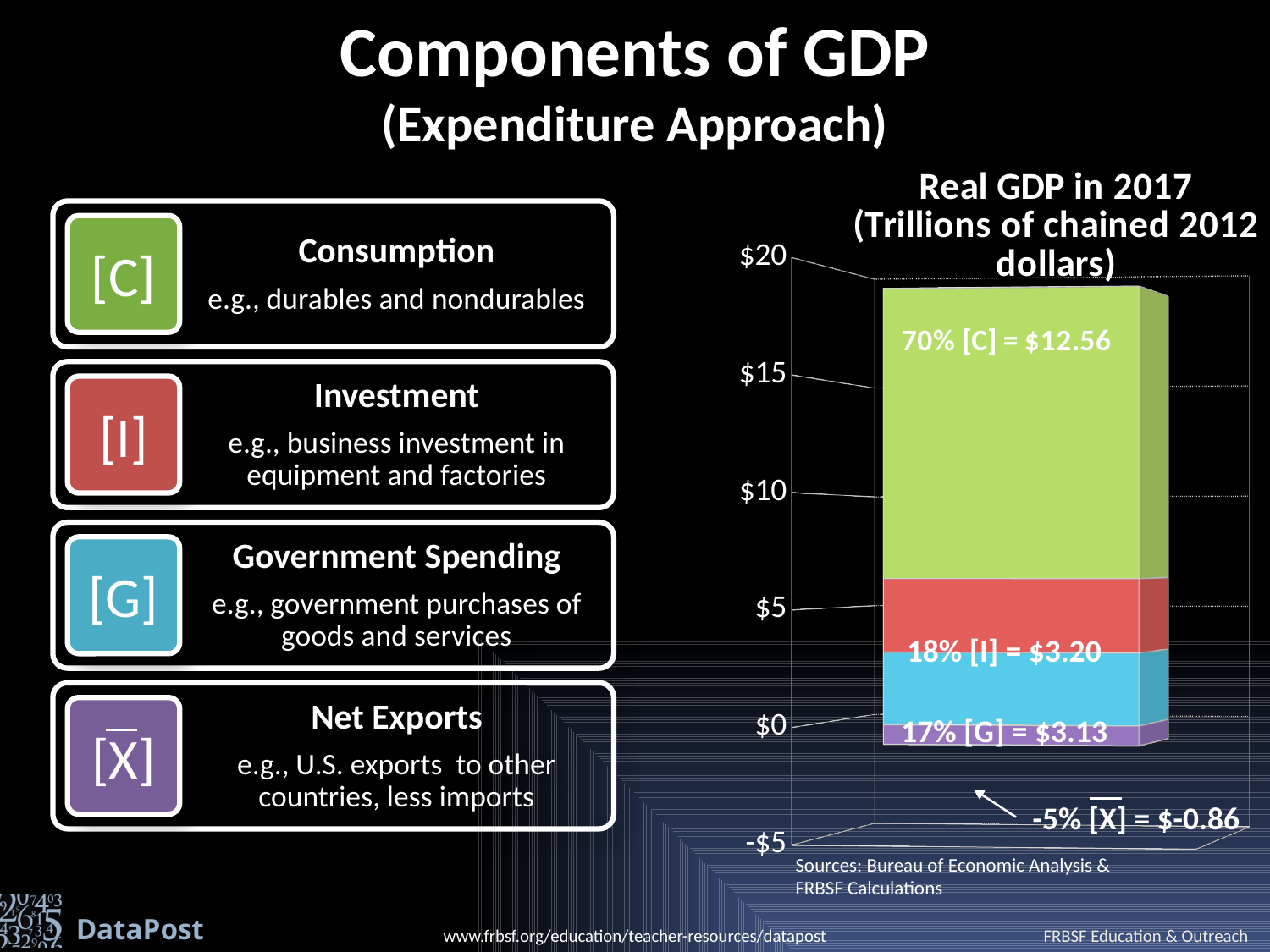
Which component of GDP has the largest value in the chart? Consumption [C] What is the value of Net Exports [X] in the Real GDP in 2017 chart? $-0.86 What is the value of Government Spending [G] in the Real GDP in 2017 chart? $3.13 How many components are stacked in the bar of the Real GDP in 2017 chart? 4 What is the value of Consumption [C] in the Real GDP in 2017 chart? $12.56 Which component of GDP has the smallest value in the chart? Net Exports [X] What is the value of Investment [I] in the Real GDP in 2017 chart? $3.20 What kind of chart is shown on the slide? stacked bar chart What percentage share of real GDP does Consumption [C] account for? 70% What percentage share of real GDP does Net Exports [X] account for? -5% What is the difference between the Consumption [C] value and the Investment [I] value? $9.36 Which is larger, the value for Investment [I] or the value for Government Spending [G]? Investment [I]